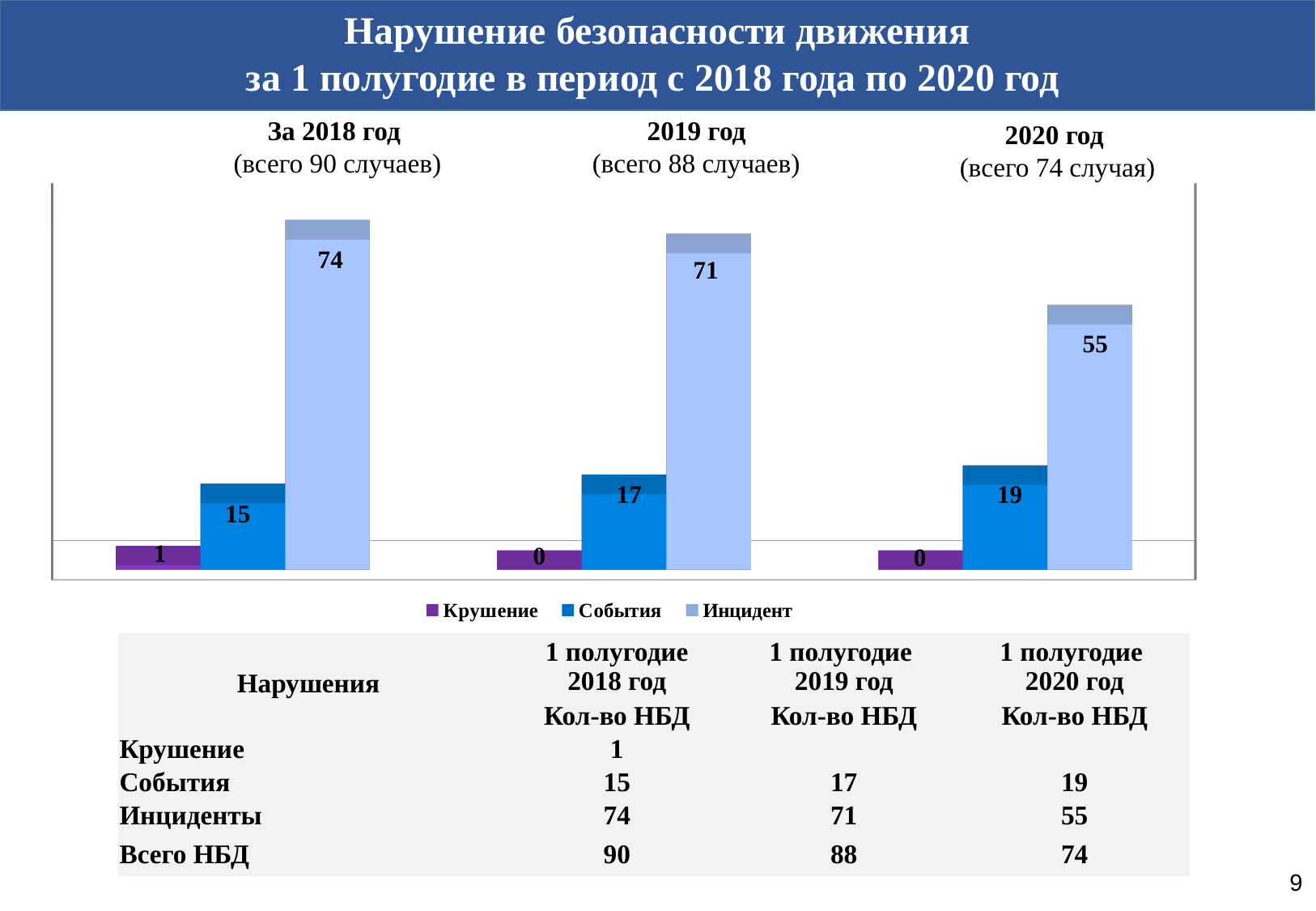
What is the difference between the Инцидент values for 2018 and 2020? 19 In which year is the Инцидент value the highest? 2018 What kind of chart is shown on the slide? bar chart Do the Инцидент values rise or fall from 2018 to 2020? fall How many year groups are shown on the x axis? 3 What is the value for События in 2020? 19 What is the value for Инцидент in 2020? 55 Which is larger, the События value for 2019 or for 2020? 2020 In which year is the События value the lowest? 2018 How many series does the legend list? 3 What is the value for Крушение in 2019? 0 What is the value for Инцидент in 2018? 74